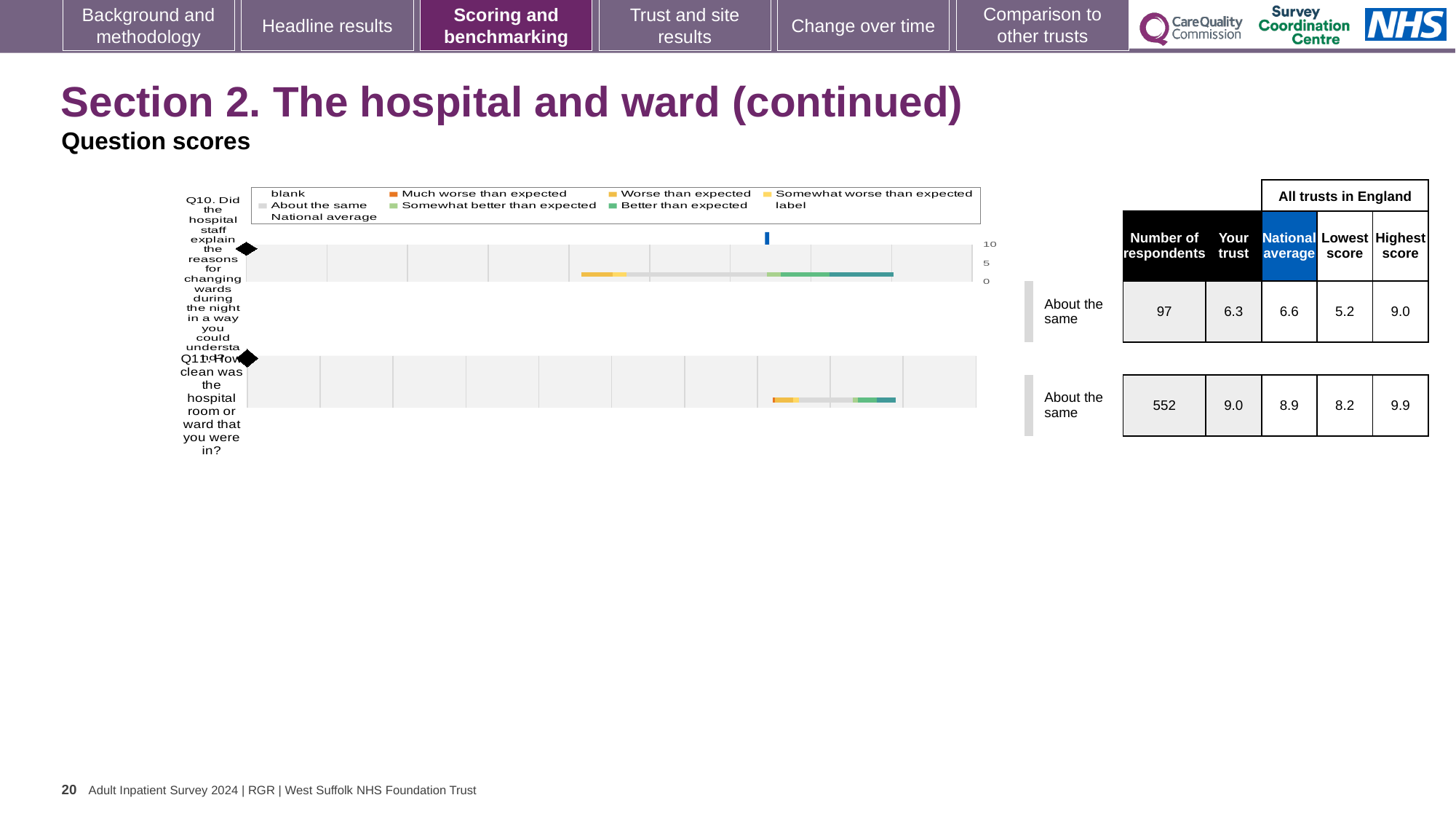
What is the 'Your trust' score for Q11 (how clean was the hospital room or ward)? 9.0 What benchmark category is shown for Q10? About the same What kind of chart is used to show the question scores for Q10 and Q11? bar chart What is the difference between the highest score and the lowest score across all trusts in England for Q11? 1.7 What is the 'Your trust' score for Q10 (explaining reasons for changing wards during the night)? 6.3 For Q11, which is larger: the trust's score or the national average? the trust's score How many questions are plotted on the slide? 2 How many respondents answered Q11? 552 What is the national average score for Q10? 6.6 What is the difference between the highest score and the lowest score across all trusts in England for Q10? 3.8 What is the national average score for Q11? 8.9 For Q10, which is larger: the trust's score or the national average? the national average